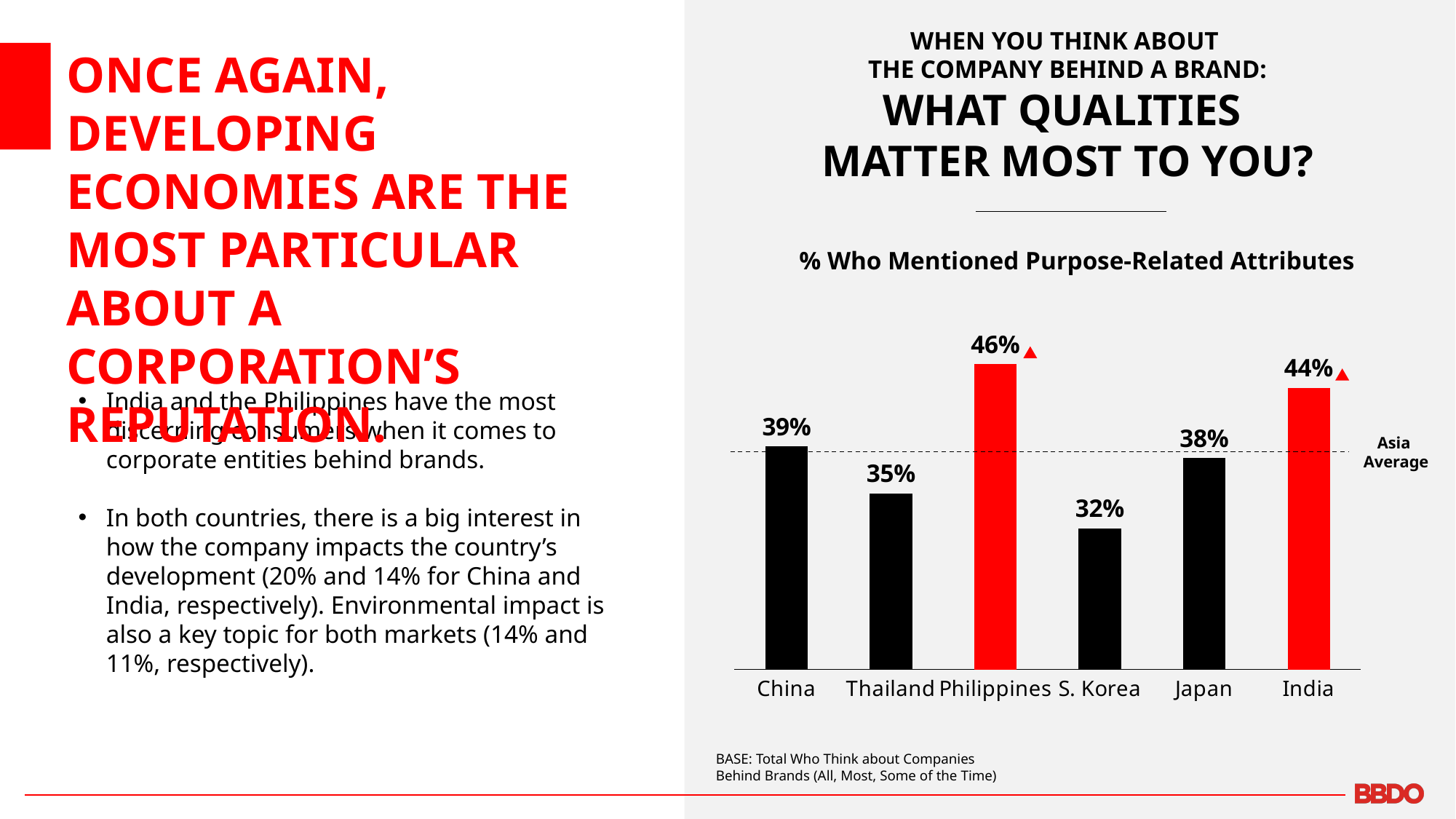
Which has a higher value, India or the Philippines? Philippines Which country has the lowest percentage who mentioned purpose-related attributes? S. Korea Which two countries' bars are coloured red in the chart? Philippines and India Which country has the highest percentage who mentioned purpose-related attributes? Philippines What percentage of respondents in China mentioned purpose-related attributes? 39% How many countries are shown in the chart? 6 What is the difference between the values for India and China? 5 percentage points Which has a higher value, Japan or Thailand? Japan What is the value shown for Japan? 38% What is the value shown for Thailand? 35% What is the difference between the values for the Philippines and S. Korea? 14 percentage points What type of chart is used to show the percentages by country? Bar chart